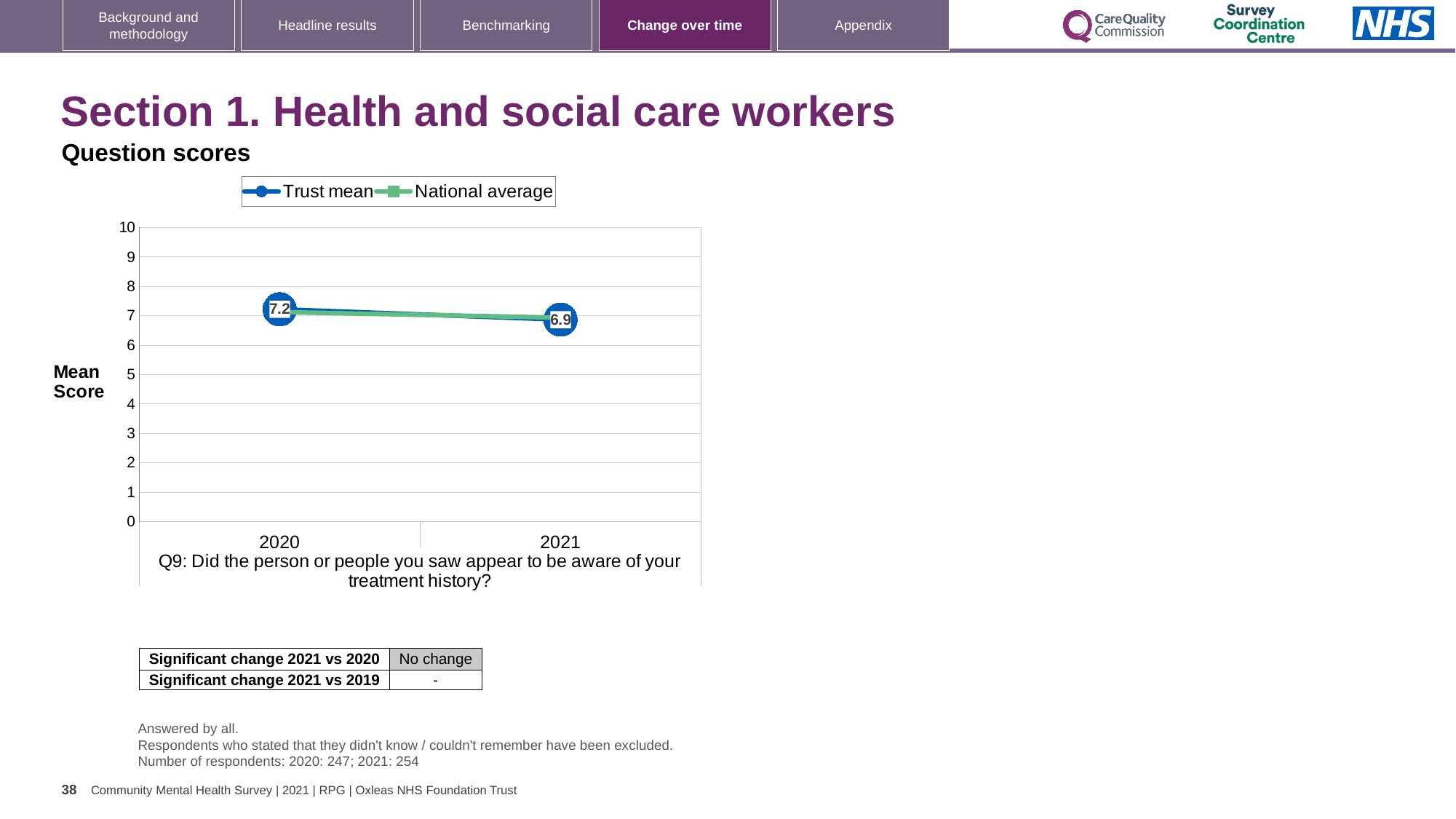
Does the Trust mean score rise or fall from 2020 to 2021? fall How many series does the chart legend list? 2 Is the National average value for 2020 greater or less than 5? greater What is the Trust mean score for 2020? 7.2 In which year was the Trust mean score higher, 2020 or 2021? 2020 What is the label on the y axis of the chart? Mean Score What kind of chart is shown on the slide? line chart How many years are plotted on the x axis of the chart? 2 By how much did the Trust mean score change from 2020 to 2021? 0.3 What are the two series named in the chart legend? Trust mean and National average What is the Trust mean score for 2021? 6.9 In which year is the Trust mean score at its lowest? 2021